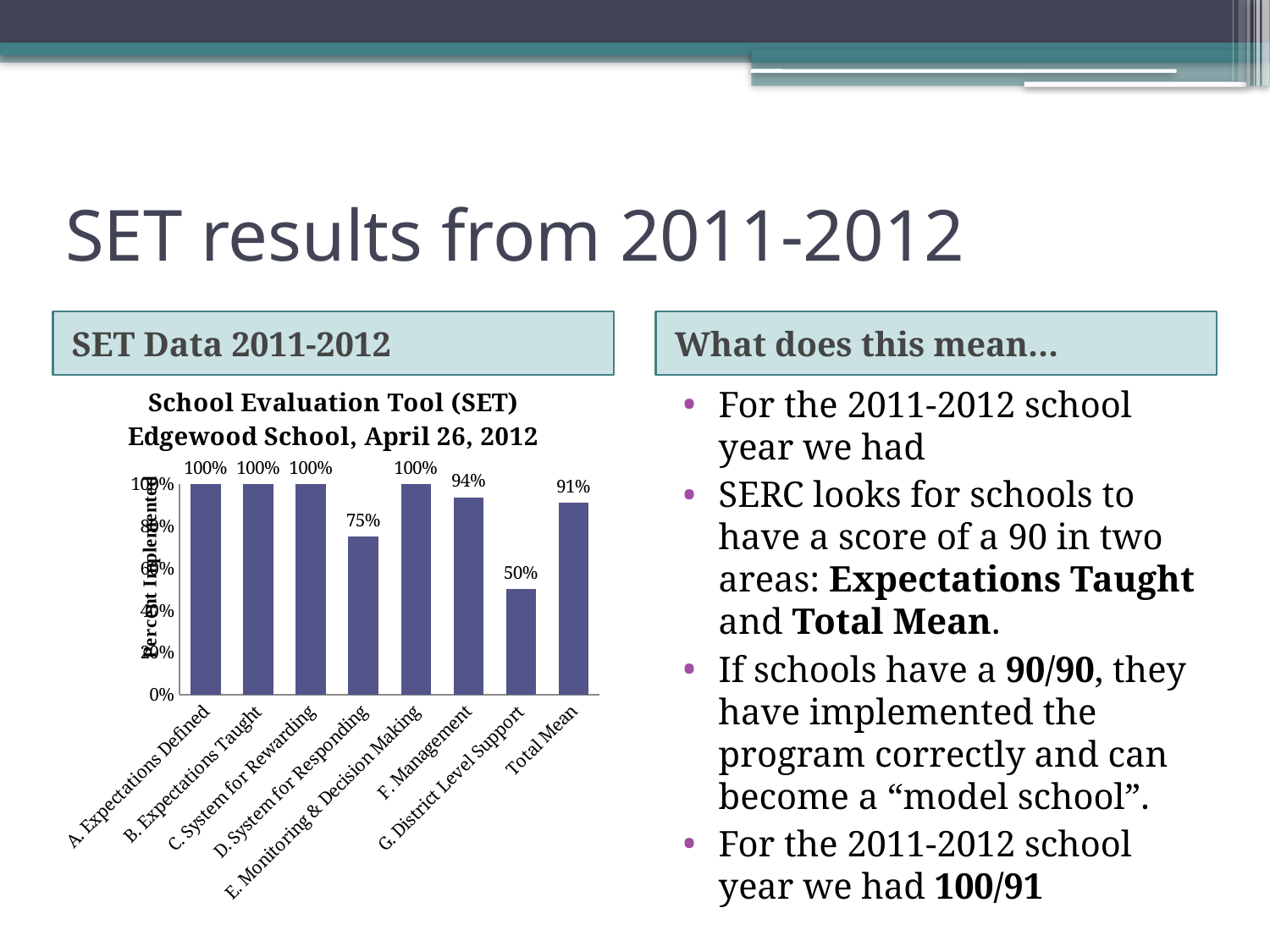
Is the value for Total Mean greater or less than 80%? greater Which is larger, the value for D. System for Responding or the value for F. Management? F. Management What is the value for D. System for Responding? 75% What is the value for F. Management? 94% Which category has the lowest value? G. District Level Support How many categories are shown on the x axis of the chart? 8 What is the value for Total Mean? 91% What is the value for G. District Level Support? 50% What kind of chart is shown on the slide? Bar chart What is the difference between the values for F. Management and G. District Level Support? 44% How many categories have a value of 100%? 4 What is the difference between the values for B. Expectations Taught and Total Mean? 9%